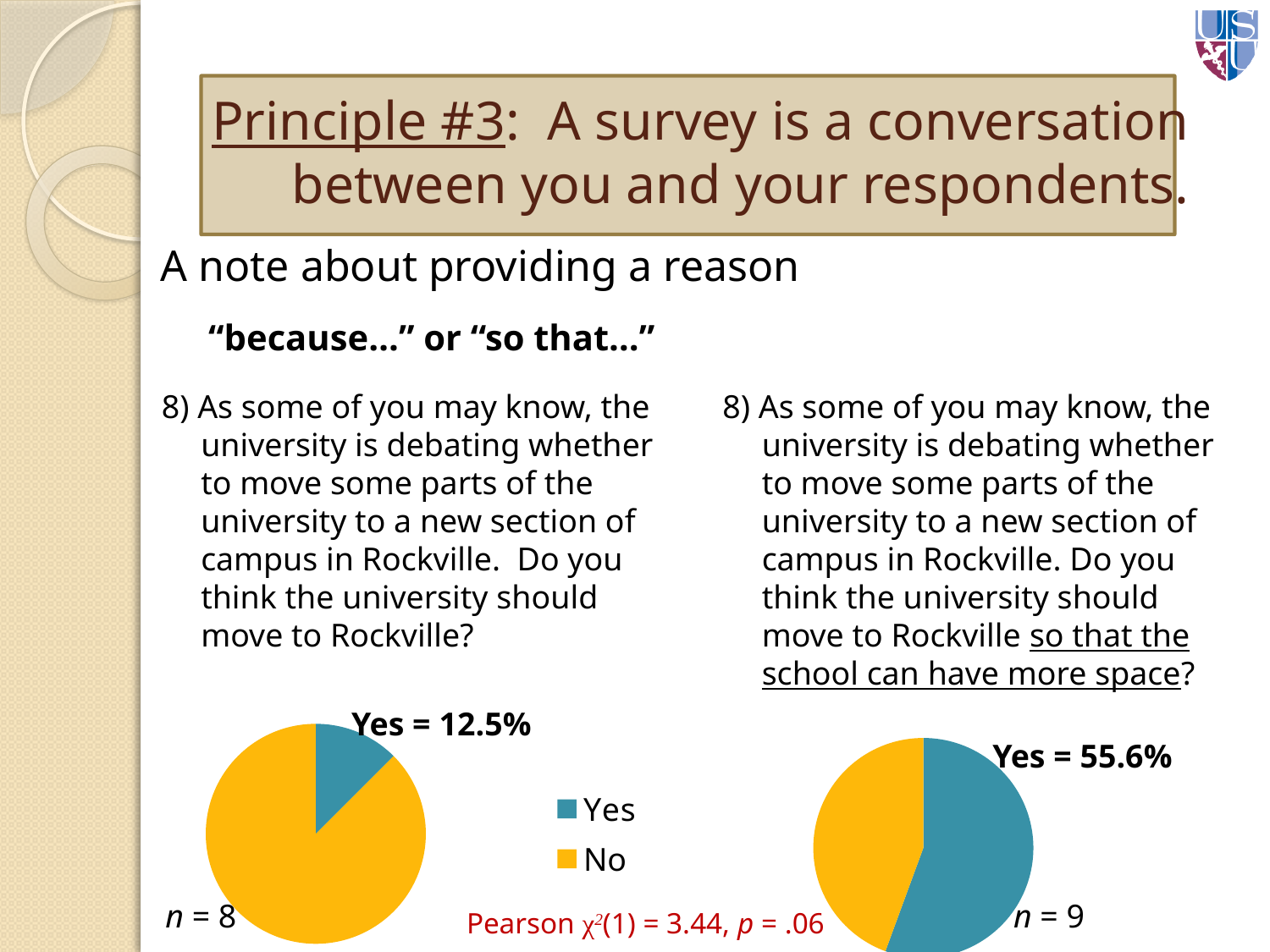
In the right pie chart, which response is the smaller slice, Yes or No? No How many slices does each pie chart have? 2 How many entries does the legend list? 2 In the right pie chart, what percentage of respondents answered Yes? 55.6% What kind of charts are shown at the bottom of the slide? Pie charts What colour represents the Yes response in the pie charts? Teal (blue-green) What is the difference in percentage points between the Yes share in the right pie chart and the Yes share in the left pie chart? 43.1 percentage points In the left pie chart, which response is the larger slice, Yes or No? No In the left pie chart, is the No share greater or less than 50%? greater In the left pie chart, what percentage of respondents answered Yes? 12.5% Which pie chart has the larger Yes share, the left one or the right one? The right one What is the sample size (n) for the left pie chart? 8